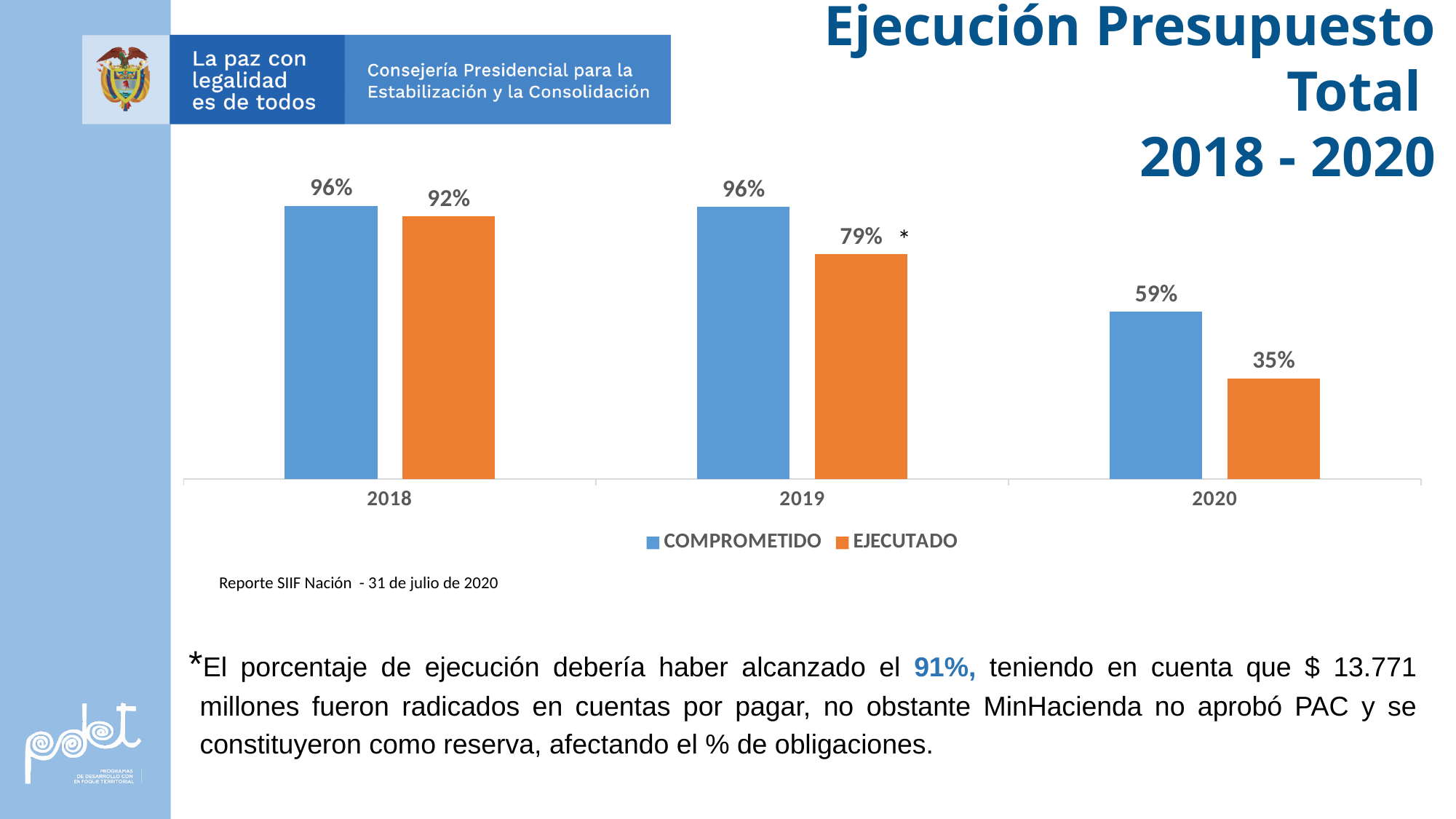
What is the EJECUTADO value for 2019? 79% Which year has the highest EJECUTADO value? 2018 How many series does the legend list? 2 How many years are shown on the x axis? 3 What is the difference between COMPROMETIDO and EJECUTADO in 2020? 24% Which year has the lowest EJECUTADO value? 2020 Which is larger in 2019, COMPROMETIDO or EJECUTADO? COMPROMETIDO What is the difference between the EJECUTADO values for 2018 and 2019? 13% What is the COMPROMETIDO value for 2018? 96% What is the EJECUTADO value for 2020? 35% What kind of chart is shown on the slide? Bar chart What is the COMPROMETIDO value for 2020? 59%